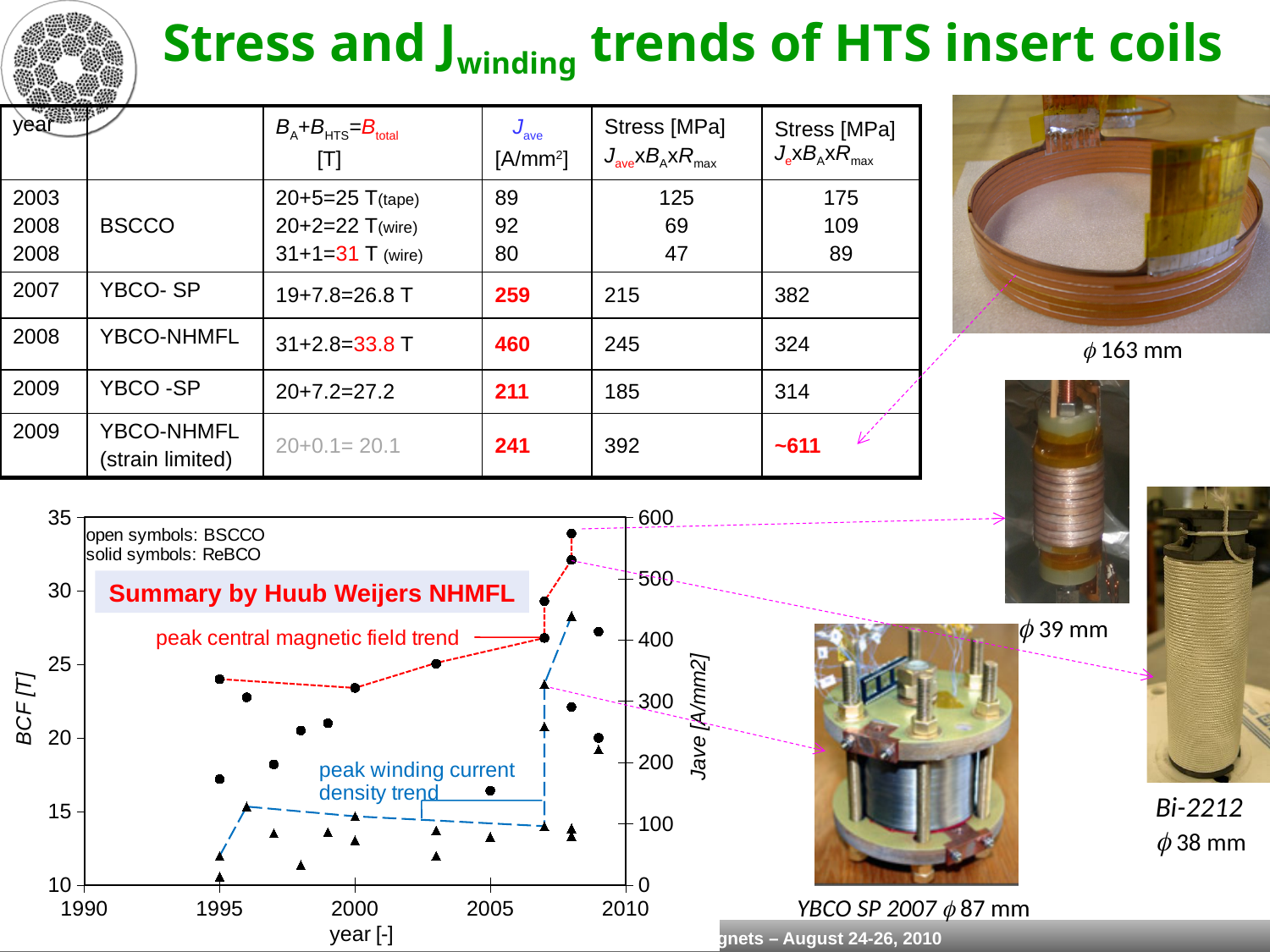
Is the starting point of the blue peak winding current density trend line at 1995 greater or less than 100 A/mm2? less What is the label of the right-hand y axis of the chart? Jave [A/mm2] On the red peak central magnetic field trend line, which is larger: the value at 2007 or the value at 2000? 2007 What kind of chart is shown at the bottom left of the slide? scatter chart Is the value of the red peak central magnetic field trend line at 2000 greater or less than 25 T? less Is the end point of the blue peak winding current density trend line at 2008 greater or less than 400 A/mm2? greater Does the blue dashed 'peak winding current density trend' line rise or fall overall from 1995 to 2008? rise In which year does the red peak central magnetic field trend line reach its highest value? 2008 Does the red dashed 'peak central magnetic field trend' line rise or fall from 1995 to 2008? rise According to the chart's note, what material do the open symbols represent? BSCCO